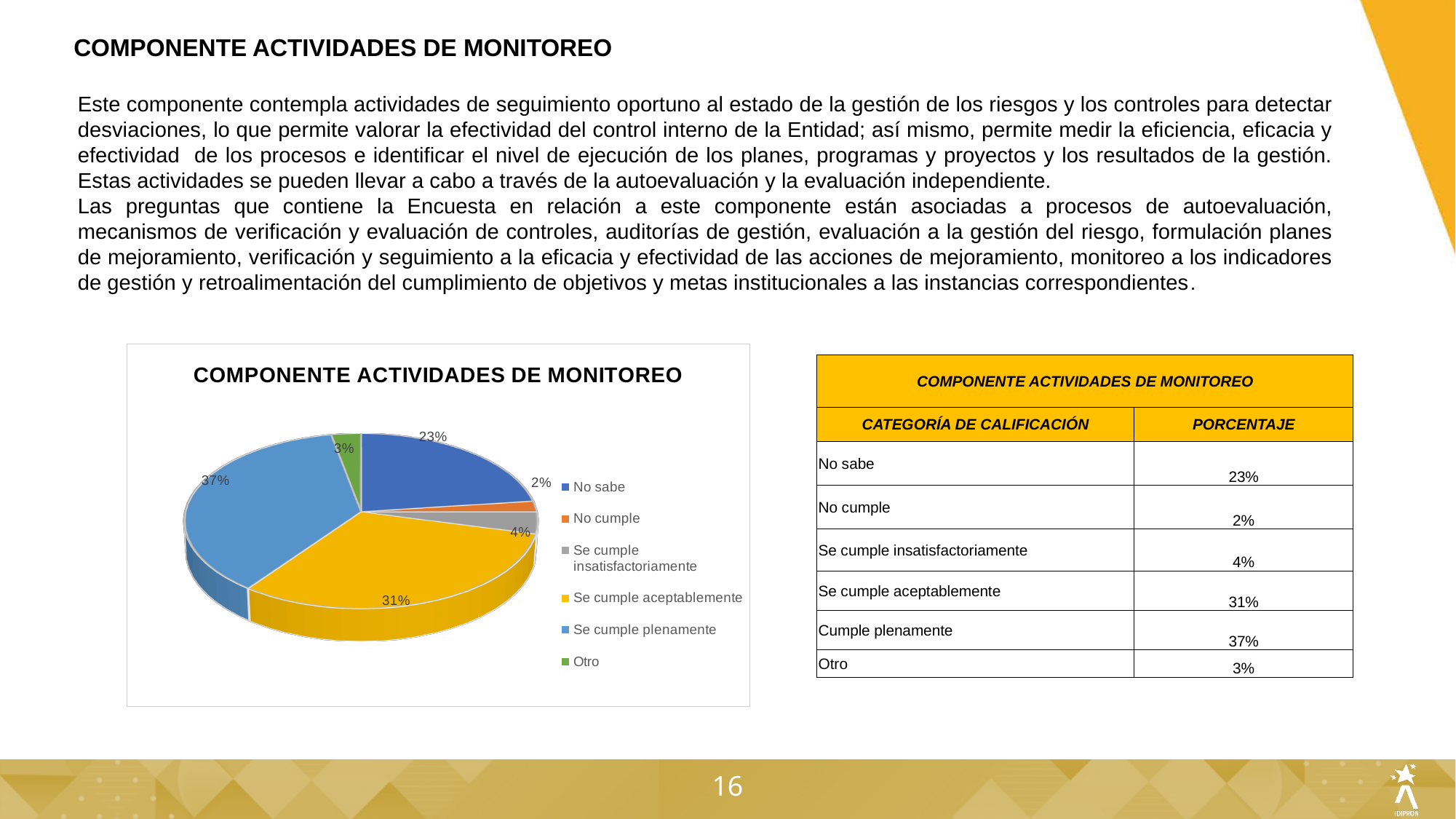
Which category has the smallest slice in the pie chart? No cumple Which category has the largest slice in the pie chart? Se cumple plenamente Which is larger, the slice for "No sabe" or the slice for "Se cumple aceptablemente"? Se cumple aceptablemente What is the value for "Otro" in the pie chart? 3% What colour is the slice for "Se cumple aceptablemente" in the pie chart? Yellow What is the value for "Se cumple plenamente" in the pie chart? 37% What is the difference between the values for "Se cumple plenamente" and "Se cumple aceptablemente"? 6% What is the value for "Se cumple insatisfactoriamente" in the pie chart? 4% What kind of chart is shown on the slide? Pie chart What is the value for "No sabe" in the pie chart? 23% How many categories does the pie chart show? 6 What is the title of the pie chart? COMPONENTE ACTIVIDADES DE MONITOREO